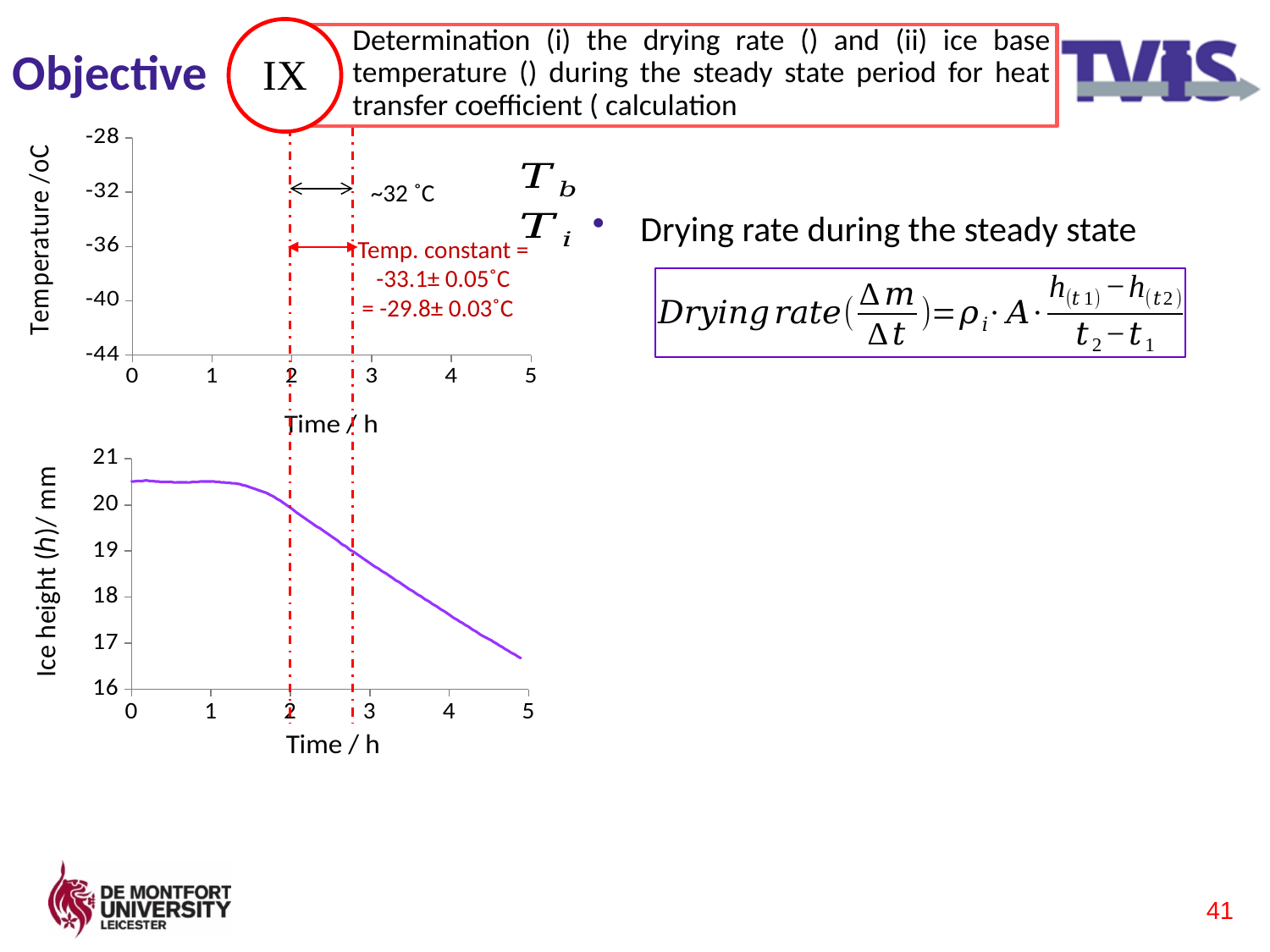
How many data lines are plotted in the bottom chart (Ice height vs Time)? 1 What is the y-axis label of the bottom chart? Ice height (h)/ mm What is the y-axis label of the top chart? Temperature /oC What is the highest tick value on the x axis of the bottom chart (Ice height vs Time)? 5 In the bottom chart (Ice height vs Time), is the ice height at 4 h greater or less than 17 mm? greater In the bottom chart (Ice height vs Time), is the ice height at 4 h greater or less than 18 mm? less In the bottom chart (Ice height vs Time), do the values rise or fall as time increases? fall In the bottom chart (Ice height vs Time), is the ice height at 3 h greater or less than 20 mm? less In the bottom chart (Ice height vs Time), which is larger: the ice height at 1 h or at 4 h? 1 h What is the lowest tick value on the y axis of the top chart (Temperature vs Time)? -44 What kind of chart is the bottom chart (Ice height vs Time)? line chart